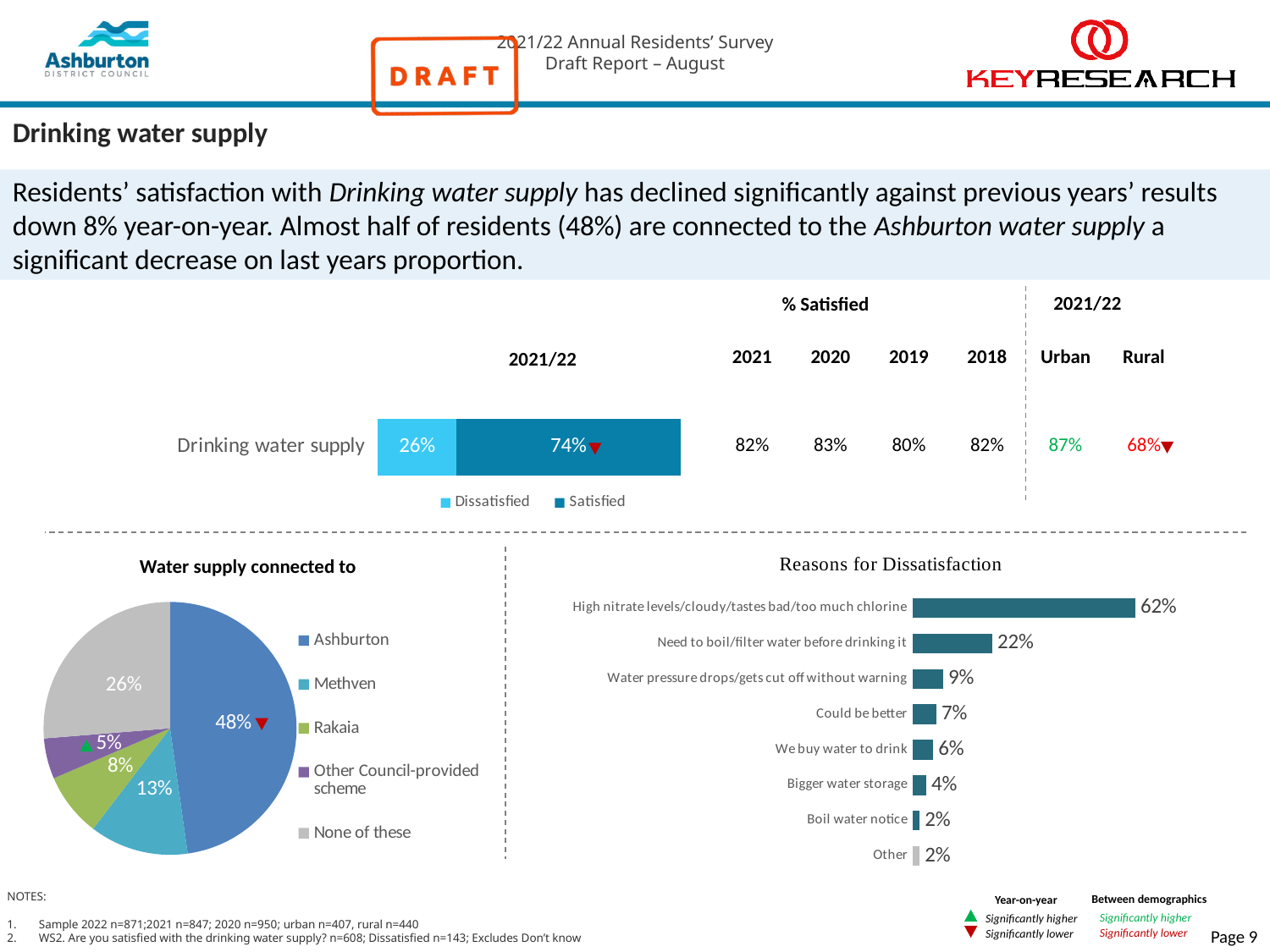
In the stacked bar chart for Drinking water supply (2021/22), what percentage is Satisfied? 74% What kind of chart is the 'Reasons for Dissatisfaction' chart? Bar chart In the stacked bar chart for Drinking water supply, what are the two legend entries? Dissatisfied and Satisfied In the 'Reasons for Dissatisfaction' chart, how many reasons are listed? 8 In the 'Reasons for Dissatisfaction' chart, which reason has the highest value? High nitrate levels/cloudy/tastes bad/too much chlorine In the 'Water supply connected to' pie chart, what is the difference between the 'None of these' share and the Rakaia share? 18% In the 'Water supply connected to' pie chart, which category has the largest share? Ashburton In the 'Reasons for Dissatisfaction' chart, what percentage is shown for 'Need to boil/filter water before drinking it'? 22% In the 'Water supply connected to' pie chart, how many categories does the legend list? 5 In the 'Reasons for Dissatisfaction' chart, which is larger: 'Could be better' or 'We buy water to drink'? Could be better In the 'Reasons for Dissatisfaction' chart, what is the difference between 'High nitrate levels/cloudy/tastes bad/too much chlorine' and 'Need to boil/filter water before drinking it'? 40% In the 'Water supply connected to' pie chart, what share is shown for Methven? 13%